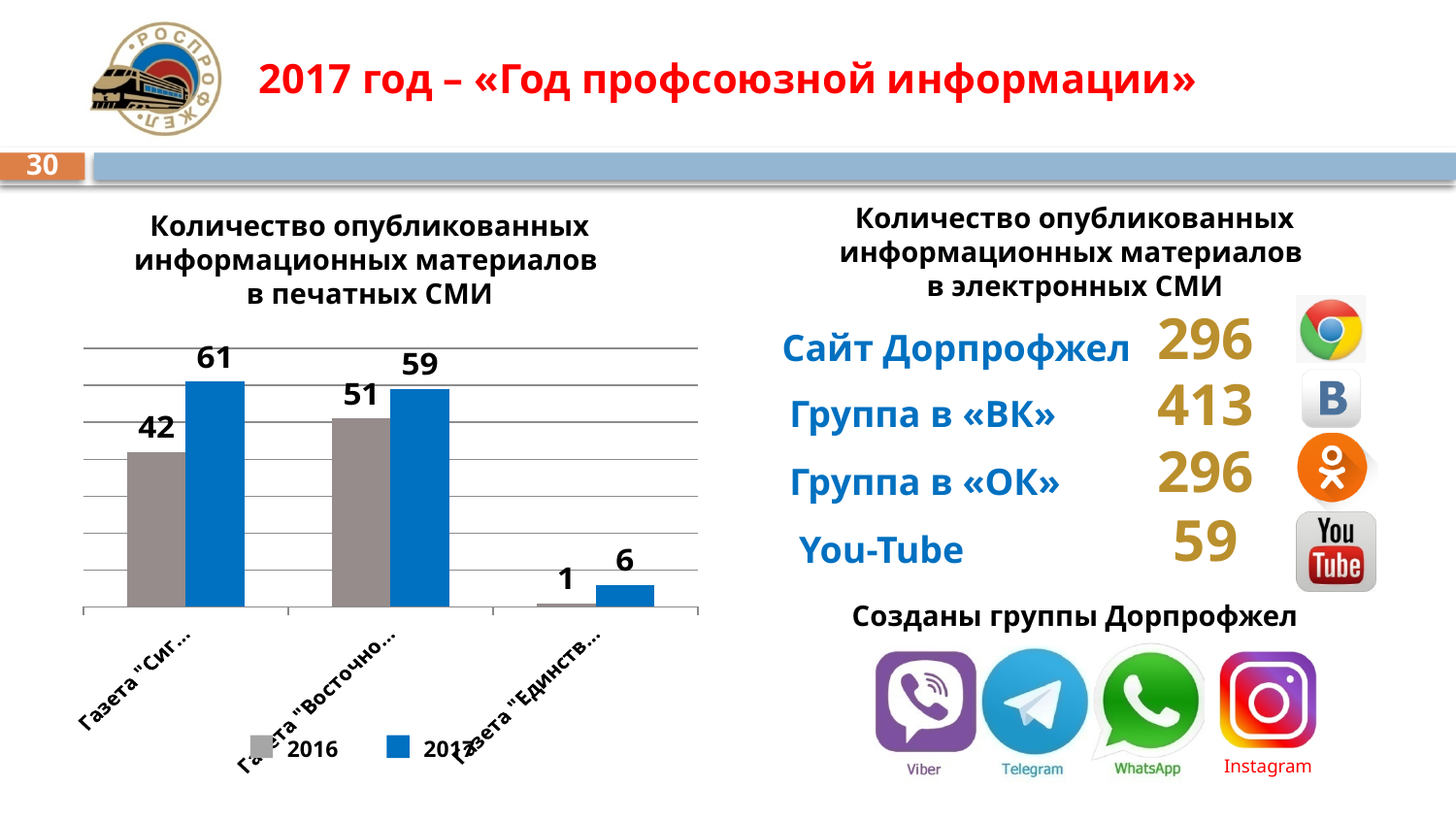
How many series does the legend of the bar chart on the left list? 2 In the bar chart on the left, what is the 2016 value for the first category (Газета "Сиг...")? 42 How many categories are shown in the bar chart on the left? 3 In the bar chart on the left, what is the difference between the 2017 and 2016 values for the first category (Газета "Сиг...")? 19 In the bar chart on the left, what is the difference between the 2017 and 2016 values for the second category (Газета "Восточно...")? 8 In the bar chart on the left, which is larger: the 2016 value for the first category or the 2016 value for the second category? The 2016 value for the second category (51) In the bar chart on the left, which category has the highest 2017 (blue) value? Газета "Сиг..." (the first category) In the bar chart on the left, what is the 2017 (blue) value for the third category (Газета "Единств...")? 6 In the bar chart on the left, what is the 2017 (blue) value for the second category (Газета "Восточно...")? 59 What type of chart is shown on the left of the slide? Bar chart In the bar chart on the left, what is the 2016 value for the third category (Газета "Единств...")? 1 In the bar chart on the left, which category has the lowest 2016 value? Газета "Единств..." (the third category)